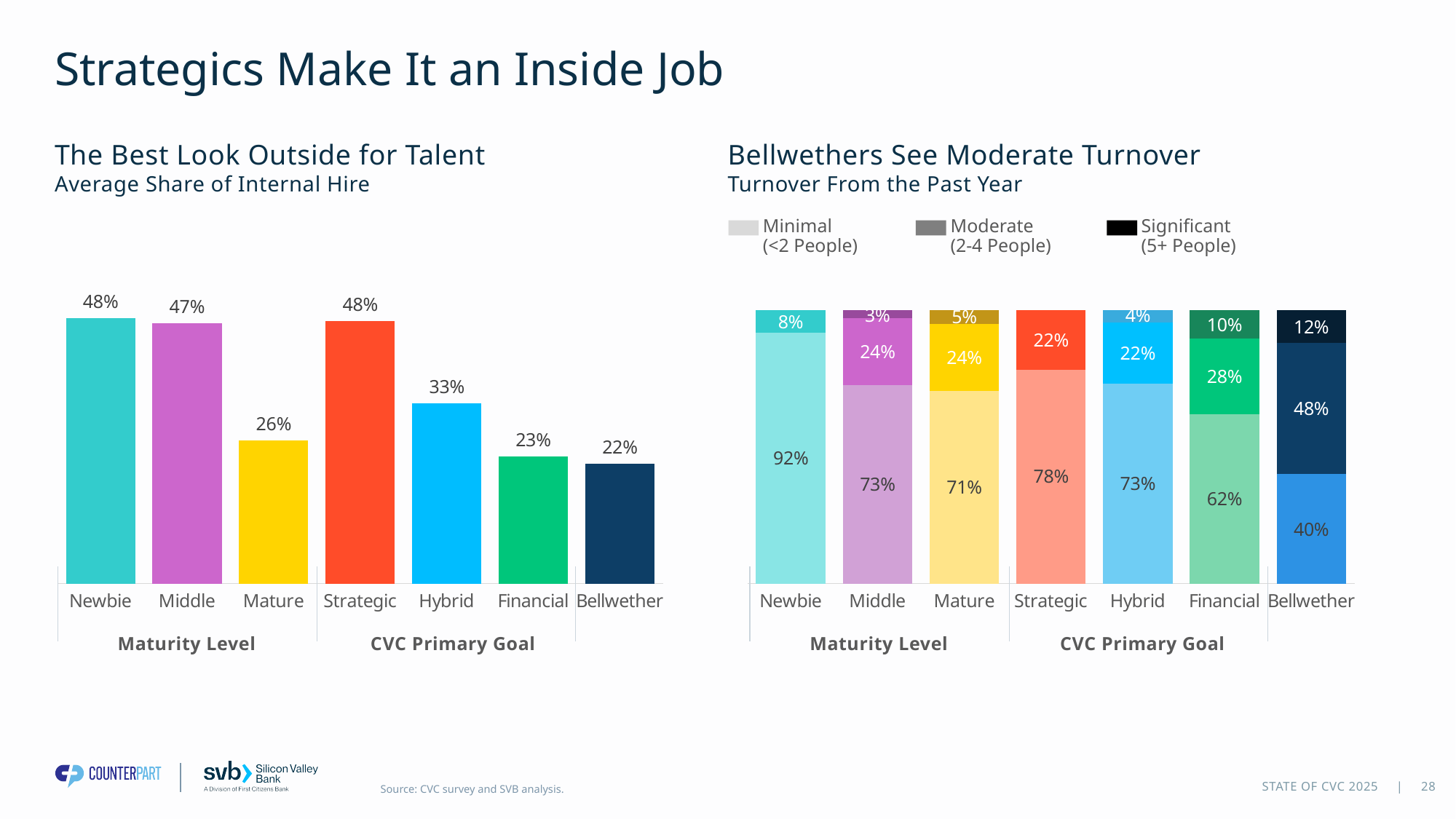
In the chart 'The Best Look Outside for Talent', which is larger, the value for Middle or the value for Mature? Middle In the chart 'Bellwethers See Moderate Turnover', which category has the lowest Minimal (<2 People) share? Bellwether How many series does the legend of the chart 'Bellwethers See Moderate Turnover' list? 3 In the chart 'The Best Look Outside for Talent', how many categories are shown? 7 In the chart 'Bellwethers See Moderate Turnover', what is the Moderate (2-4 People) share for Bellwether? 48% In the chart 'Bellwethers See Moderate Turnover', which category has the highest Significant (5+ People) share? Bellwether What kind of chart is 'The Best Look Outside for Talent'? Bar chart In the chart 'Bellwethers See Moderate Turnover', what is the total of the Moderate and Significant shares for Financial? 38% In the chart 'Bellwethers See Moderate Turnover', what is the Minimal (<2 People) share for Newbie? 92% In the chart 'The Best Look Outside for Talent', what is the value for Hybrid? 33% In the chart 'The Best Look Outside for Talent', what is the difference between the values for Strategic and Financial? 25% In the chart 'The Best Look Outside for Talent', what is the average share of internal hire for Mature? 26%